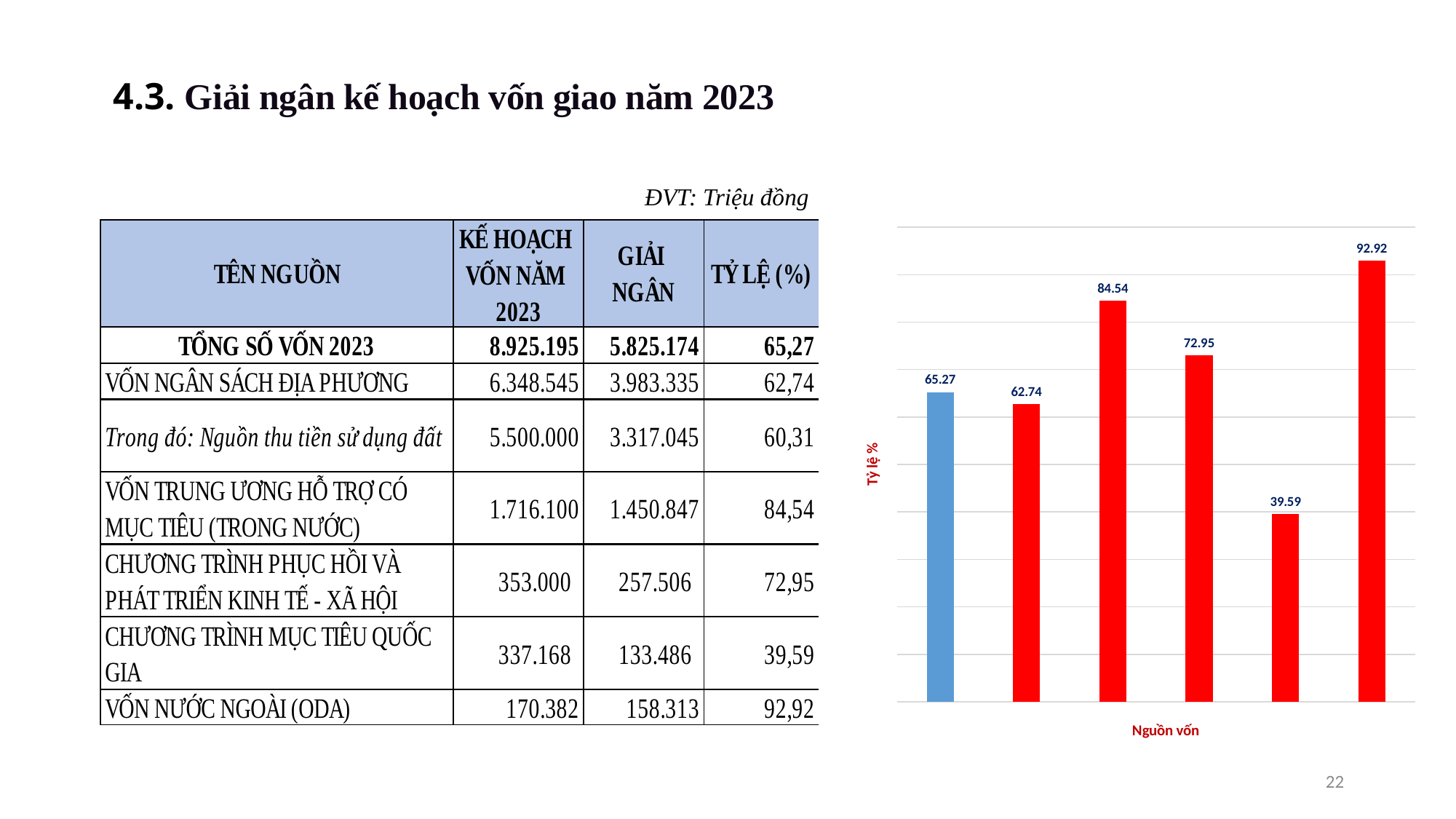
What is the difference between the values of the last bar (92.92) and the fifth bar (39.59)? 53.33 What is the title of the vertical axis of the chart? Tỷ lệ % What is the value labelled on the first (blue) bar in the chart? 65.27 What is the value labelled on the fifth bar in the chart? 39.59 What is the title of the horizontal axis of the chart? Nguồn vốn What kind of chart is shown on the right of the slide? bar chart What is the highest value labelled on any bar in the chart? 92.92 How many bars are plotted in the chart? 6 Which is larger in the chart: the third bar (84.54) or the fourth bar (72.95)? the third bar (84.54) What is the value labelled on the second bar in the chart? 62.74 What is the lowest value labelled on any bar in the chart? 39.59 What is the value labelled on the third bar in the chart? 84.54